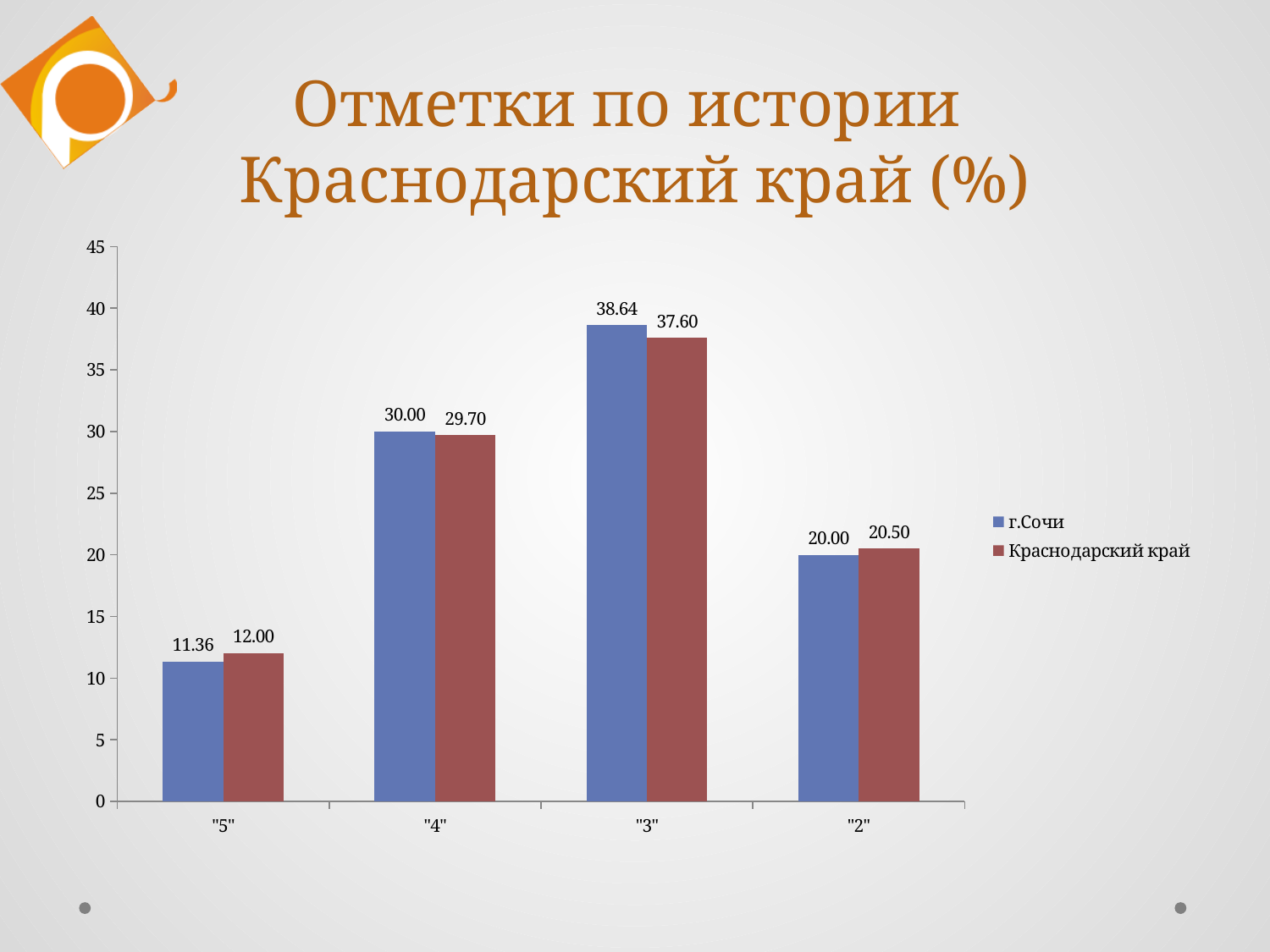
Is the value for г.Сочи for grade "4" greater or less than 25? greater What is the value for г.Сочи for grade "5"? 11.36 How many series does the legend list? 2 Which grade category has the lowest value for Краснодарский край? "5" What kind of chart is shown on the slide? bar chart What is the difference between the г.Сочи values for grade "4" and grade "2"? 10.00 What is the difference between г.Сочи and Краснодарский край for grade "3"? 1.04 What is the value for Краснодарский край for grade "2"? 20.50 What is the value for Краснодарский край for grade "3"? 37.60 Which grade category has the highest value for г.Сочи? "3" How many grade categories are shown on the x axis? 4 Which is larger for grade "5": г.Сочи or Краснодарский край? Краснодарский край